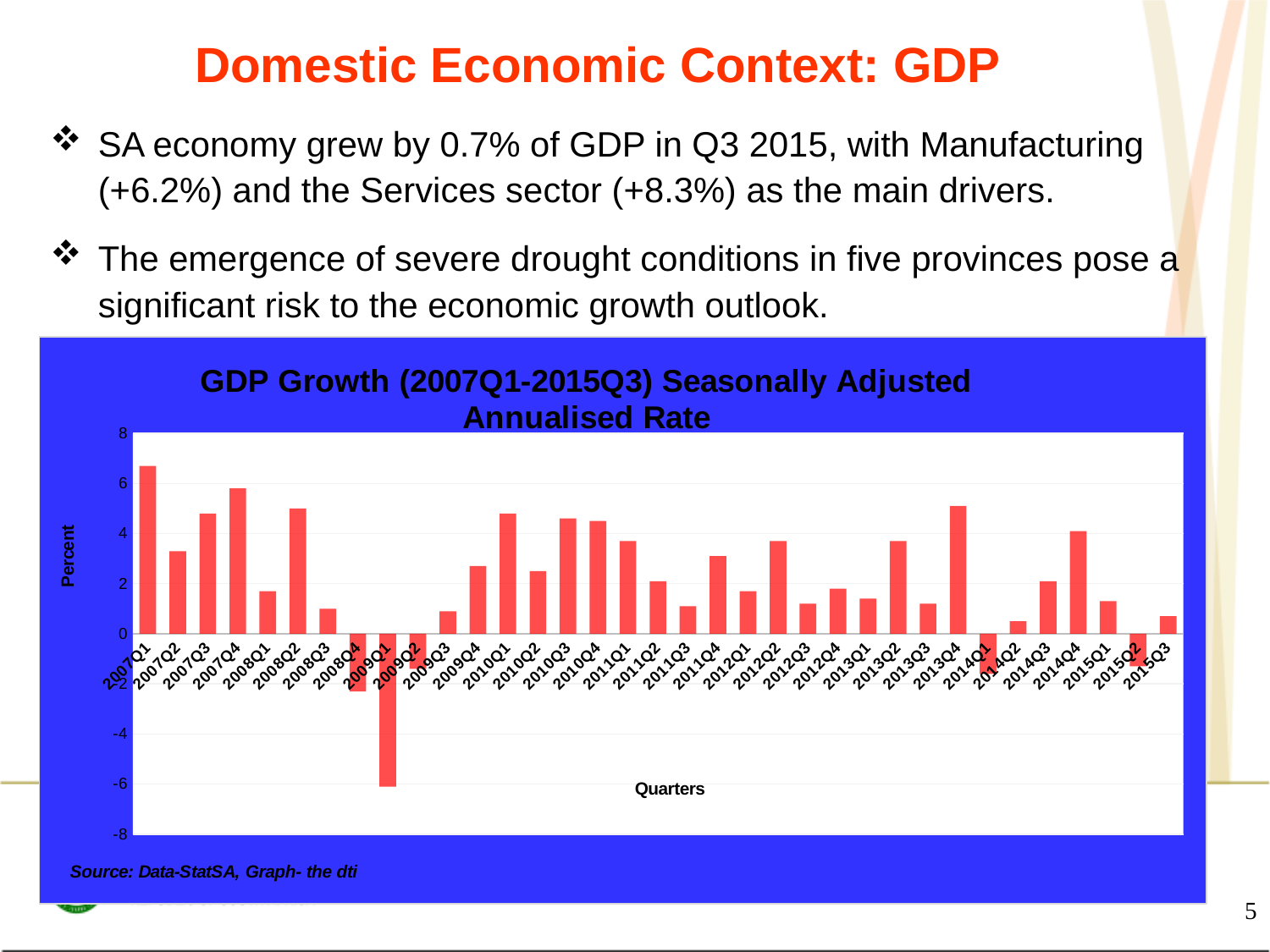
What is the label on the vertical axis of the chart? Percent Which quarter has the highest GDP growth in the chart? 2007Q1 Is the value for 2007Q1 greater or less than 6? greater Is the value for 2015Q3 greater or less than 2? less How many quarters are plotted in the chart? 35 Is the value for 2013Q4 greater or less than 4? greater Which is larger, the value for 2014Q4 or the value for 2015Q1? 2014Q4 Which quarter has the lowest GDP growth in the chart? 2009Q1 Which is larger, the value for 2010Q1 or the value for 2010Q2? 2010Q1 How many quarters in the chart show negative GDP growth? 5 What kind of chart is shown on the slide? Bar chart